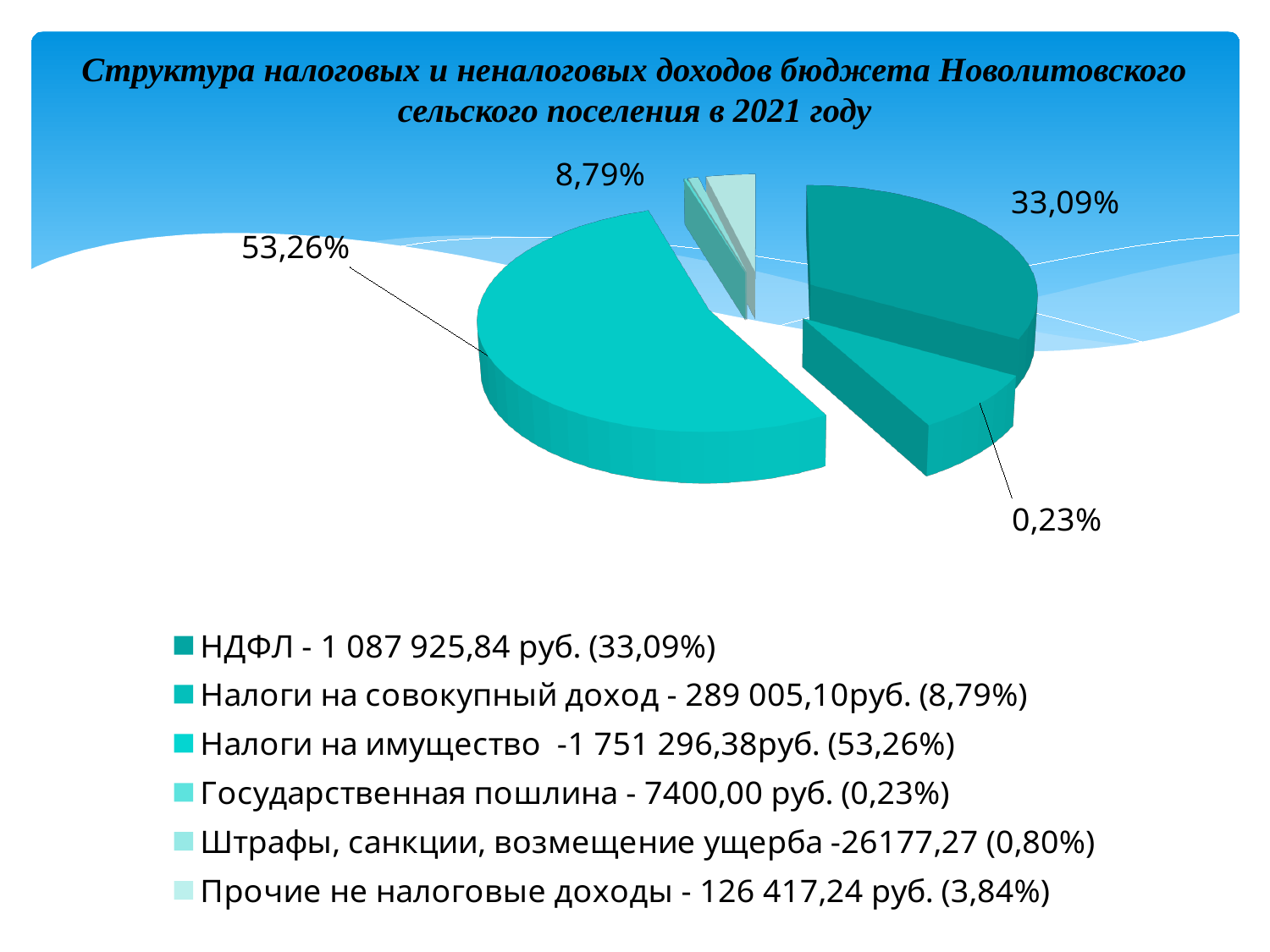
What share of the pie does Налоги на совокупный доход account for? 8,79% Which category has the smallest share of the pie? Государственная пошлина What kind of chart is shown on the slide? Pie chart What share of the pie does Штрафы, санкции, возмещение ущерба account for? 0,80% What is the title of the chart? Структура налоговых и неналоговых доходов бюджета Новолитовского сельского поселения в 2021 году What amount in rubles is shown in the legend for Государственная пошлина? 7400,00 руб. Which is larger: the share for НДФЛ or the share for Налоги на совокупный доход? НДФЛ How many categories does the legend of the pie chart list? 6 What share of the pie does Прочие не налоговые доходы account for? 3,84% By how many percentage points does the share of Налоги на имущество exceed the share of НДФЛ? 20,17 Which category has the largest share of the pie? Налоги на имущество